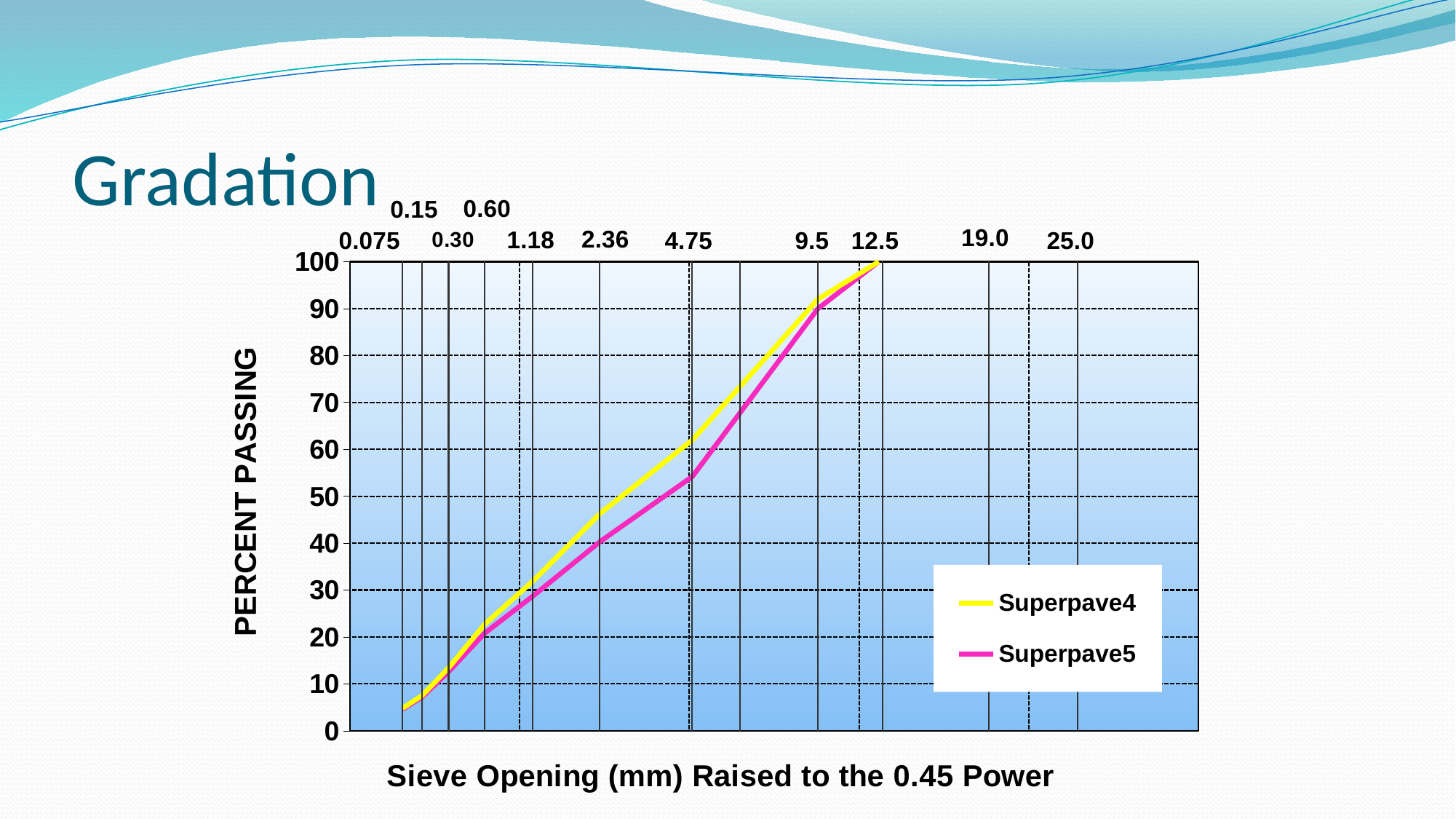
Is the value for Superpave4 at the 0.075 sieve greater or less than 10? less What kind of chart is shown on the slide? line chart Is the value for Superpave5 at the 4.75 sieve greater or less than 50? greater Is the value for Superpave5 at the 4.75 sieve greater or less than 60? less Which series is drawn in yellow? Superpave4 How many series does the legend list? 2 How many sieve opening sizes are labelled along the x axis? 11 At the 4.75 sieve, which series has the higher percent passing, Superpave4 or Superpave5? Superpave4 What is the title of the x axis? Sieve Opening (mm) Raised to the 0.45 Power At the 2.36 sieve, which series has the lower percent passing, Superpave4 or Superpave5? Superpave5 Do the percent passing values rise or fall as the sieve opening increases along the x axis? rise